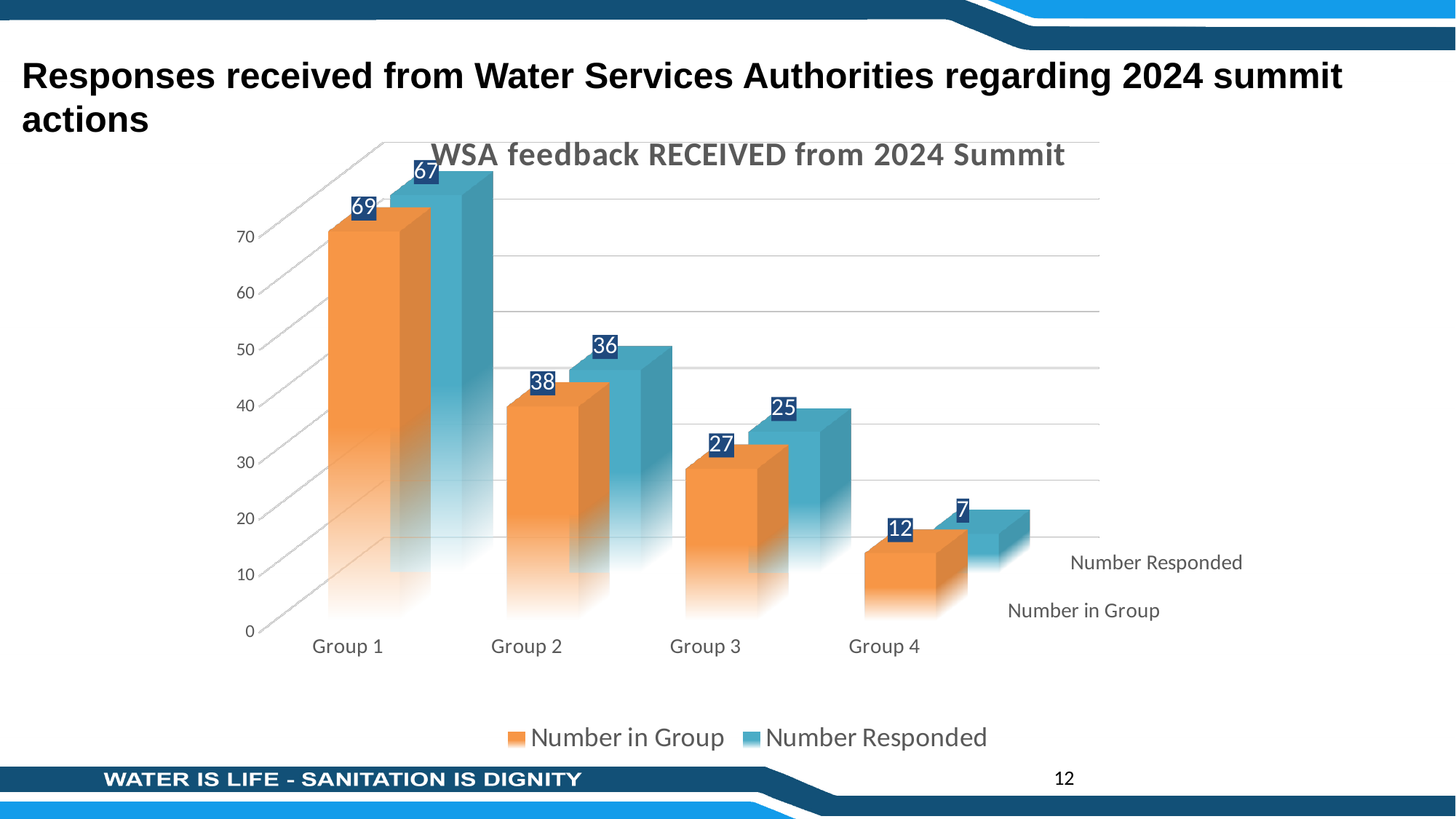
What kind of chart is shown? Bar chart How many series does the legend list? 2 What is the difference between Number in Group and Number Responded for Group 3? 2 Which is larger for Group 4: Number in Group or Number Responded? Number in Group Which group has the lowest Number in Group? Group 4 What is the Number Responded for Group 4? 7 What is the difference between the Number in Group for Group 1 and Group 2? 31 How many groups are shown on the x axis? 4 What is the Number in Group for Group 1? 69 Which group has the highest Number Responded? Group 1 Does the Number Responded rise or fall from Group 1 to Group 4? Fall What is the Number Responded for Group 2? 36